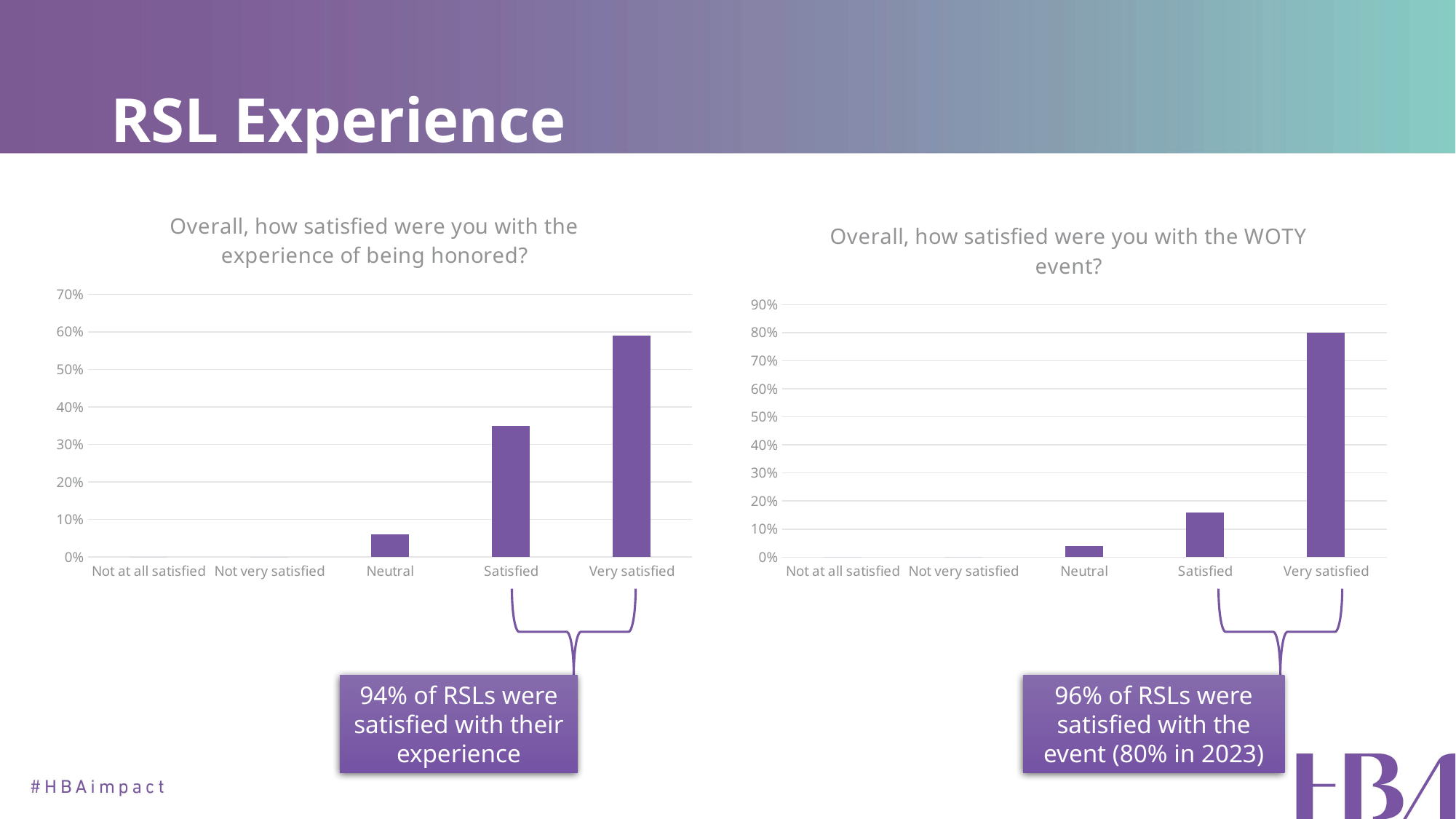
In the chart titled "Overall, how satisfied were you with the experience of being honored?", which category has the highest value? Very satisfied In the chart titled "Overall, how satisfied were you with the experience of being honored?", which is larger, the value for Satisfied or the value for Very satisfied? Very satisfied According to the callout below the chart titled "Overall, how satisfied were you with the WOTY event?", what percentage of RSLs were satisfied with the event? 96% In the chart titled "Overall, how satisfied were you with the WOTY event?", what is the highest value shown on the vertical axis? 90% In the chart titled "Overall, how satisfied were you with the WOTY event?", which category has the highest value? Very satisfied In the chart titled "Overall, how satisfied were you with the WOTY event?", do the values rise or fall moving from Neutral to Very satisfied along the x axis? rise In the chart titled "Overall, how satisfied were you with the experience of being honored?", is the value for Satisfied greater or less than 30%? greater In the chart titled "Overall, how satisfied were you with the experience of being honored?", how many categories are shown on the x axis? 5 In the chart titled "Overall, how satisfied were you with the experience of being honored?", is the value for Neutral greater or less than 10%? less In the chart titled "Overall, how satisfied were you with the WOTY event?", is the value for Satisfied greater or less than 20%? less In the chart titled "Overall, how satisfied were you with the experience of being honored?", what kind of chart is shown? bar chart